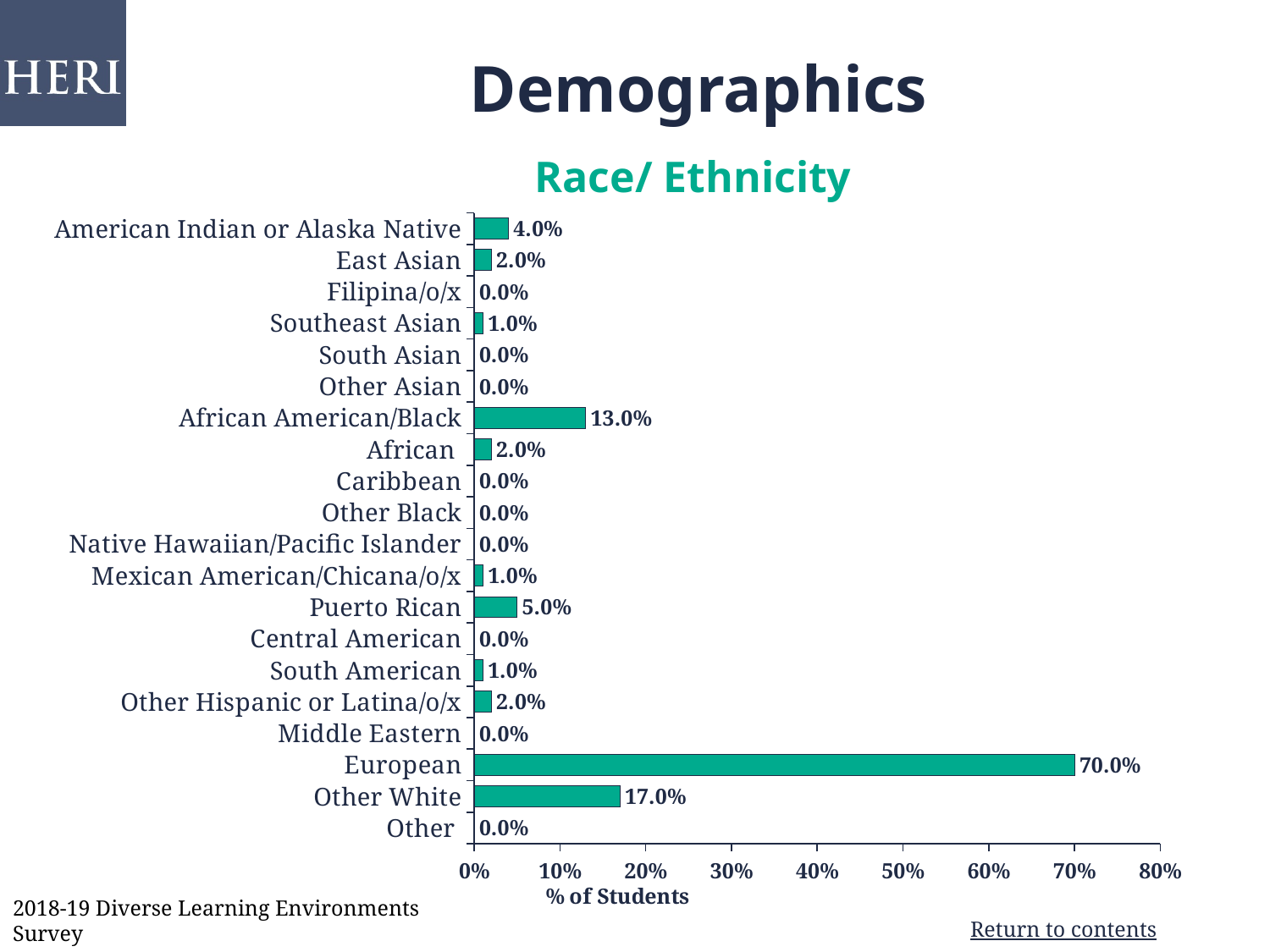
Which is larger, the value for American Indian or Alaska Native or the value for East Asian? American Indian or Alaska Native What is the difference between the values for European and Other White? 53.0% Is the value for European greater or less than 60%? greater What is the value for European? 70.0% What is the title of the chart? Race/ Ethnicity How many categories are shown on the chart? 20 Which category has the highest value? European What is the value for Other White? 17.0% What kind of chart is shown on the slide? Bar chart What is the value for Puerto Rican? 5.0% What is the value for African American/Black? 13.0% What is the difference between the values for African American/Black and Puerto Rican? 8.0%